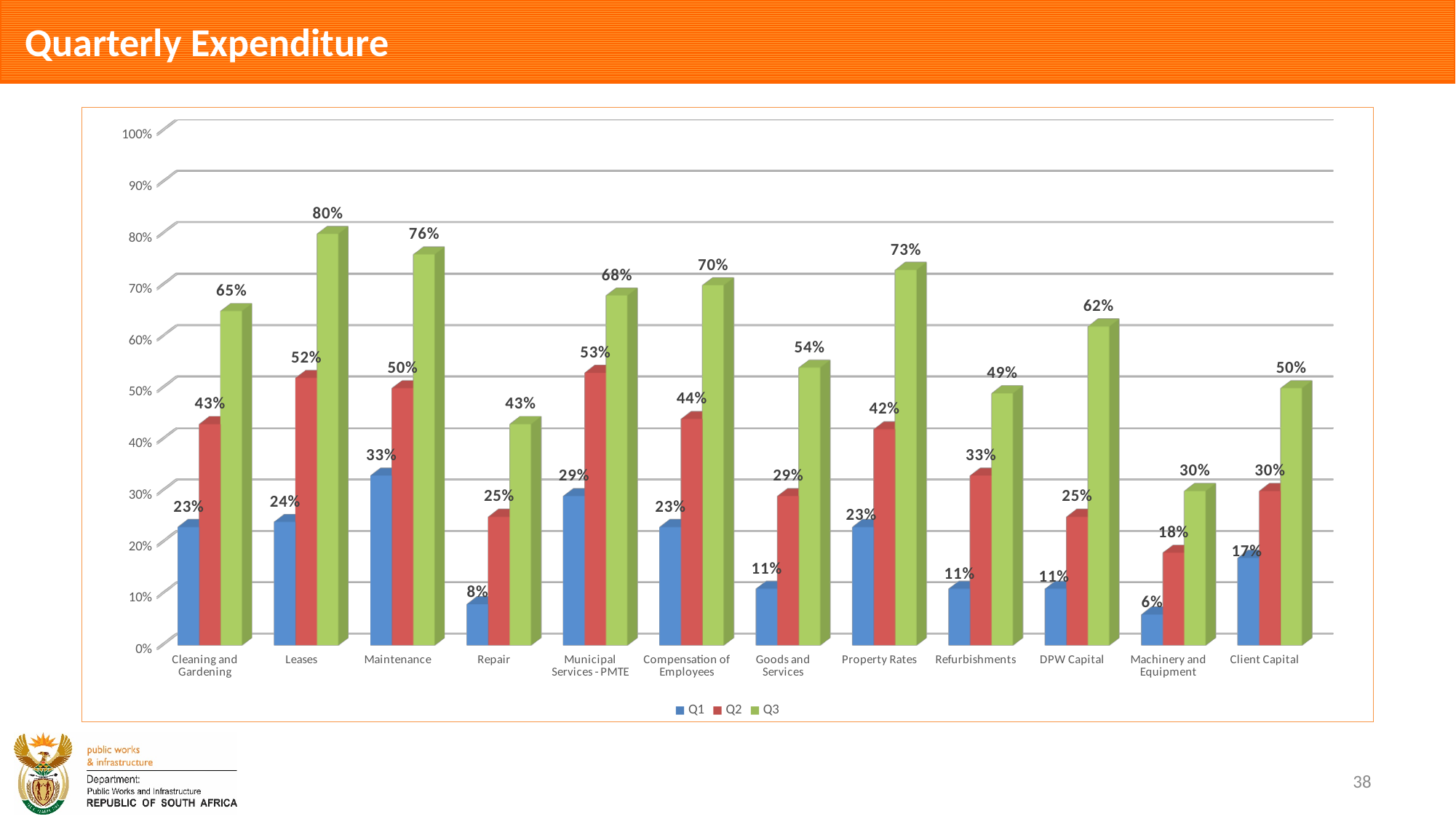
Which is larger, the Q2 value for Property Rates or the Q2 value for Compensation of Employees? Compensation of Employees What kind of chart is shown on the slide? Bar chart Is the Q3 value for DPW Capital greater or less than 60%? greater What is the Q1 value for Repair? 8% What is the difference between the Q3 and Q1 values for Maintenance? 43% What is the Q2 value for Municipal Services - PMTE? 53% How many categories are shown on the x axis? 12 What is the title of the slide? Quarterly Expenditure How many series does the legend list? 3 Which category has the lowest Q1 value? Machinery and Equipment What is the Q3 value for Leases? 80% Which category has the highest Q3 value? Leases